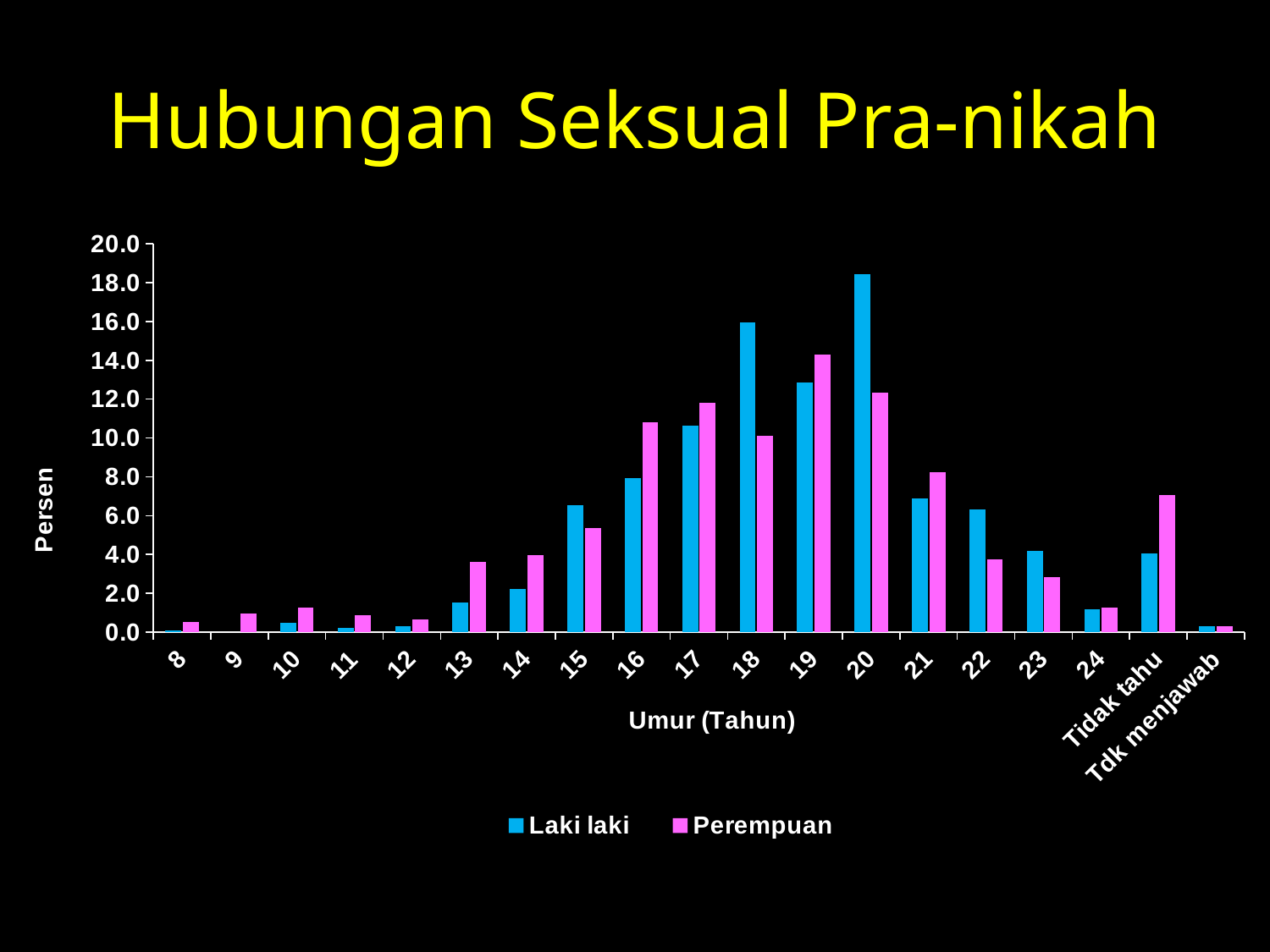
What kind of chart is shown on the slide? bar chart At which age is the Perempuan value highest? 19 How many series does the legend list? 2 At age 18, which series has the larger value, Laki laki or Perempuan? Laki laki What is the title of the chart? Hubungan Seksual Pra-nikah Is the Perempuan value for Tidak tahu greater or less than 6.0? greater At which age is the Laki laki value highest? 20 At age 16, which series has the larger value, Laki laki or Perempuan? Perempuan Is the Laki laki value at age 20 greater or less than 16.0? greater Do the Perempuan values rise or fall from age 20 to age 24? fall Is the Laki laki value at age 22 greater or less than 8.0? less How many categories are shown on the x axis? 19